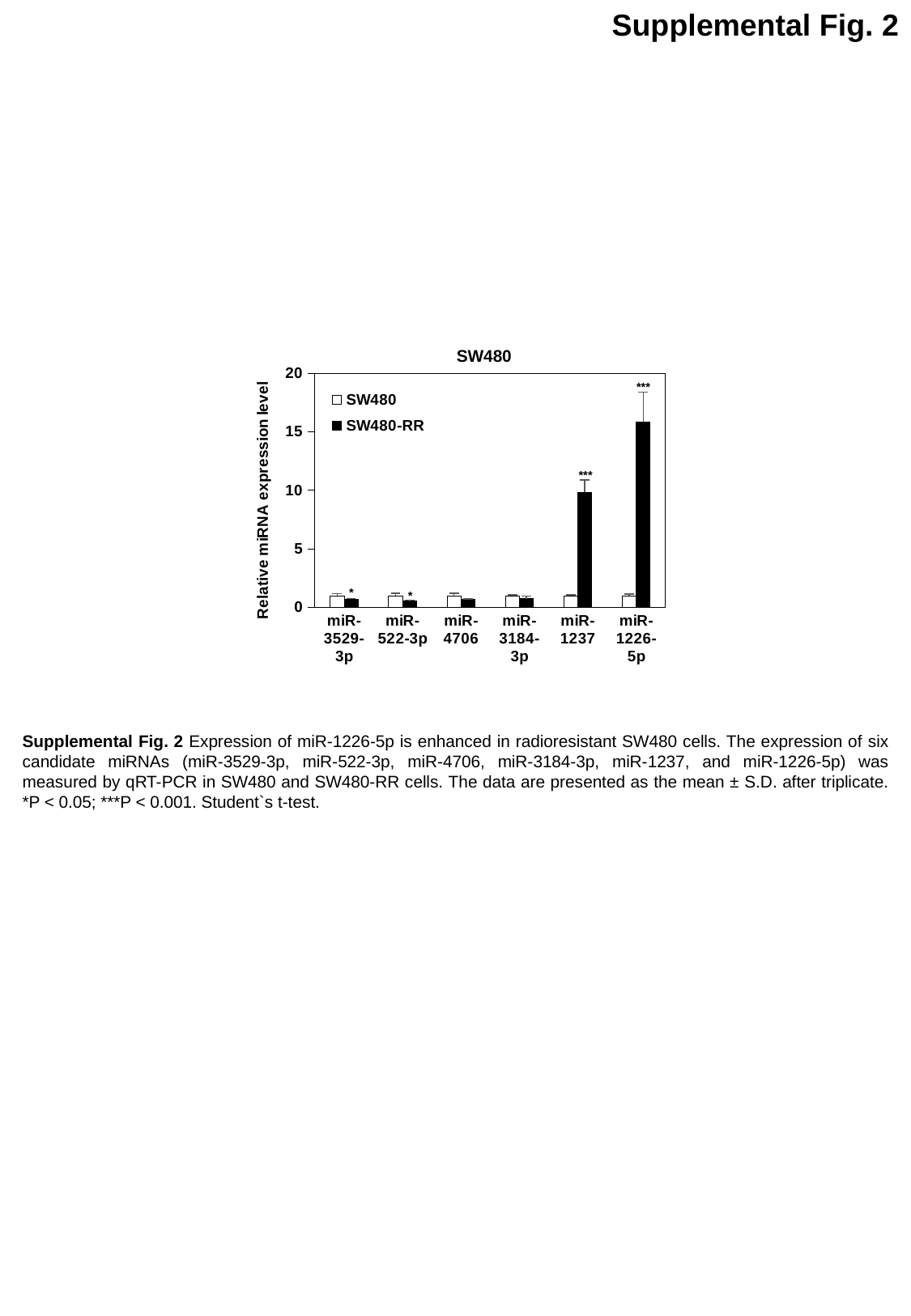
What is the label of the y axis? Relative miRNA expression level Is the SW480-RR value for miR-1237 greater or less than 5? greater Is the SW480-RR value for miR-4706 greater or less than 5? less How many miRNA categories are shown on the x axis? 6 Which is larger, the SW480-RR value for miR-1226-5p or for miR-1237? miR-1226-5p Which miRNA has the highest SW480-RR value? miR-1226-5p How many series does the legend list? 2 Which is larger for miR-1237, the SW480 value or the SW480-RR value? SW480-RR What kind of chart is shown on the slide? bar chart Is the SW480-RR value for miR-1226-5p greater or less than 10? greater What is the title of the chart? SW480